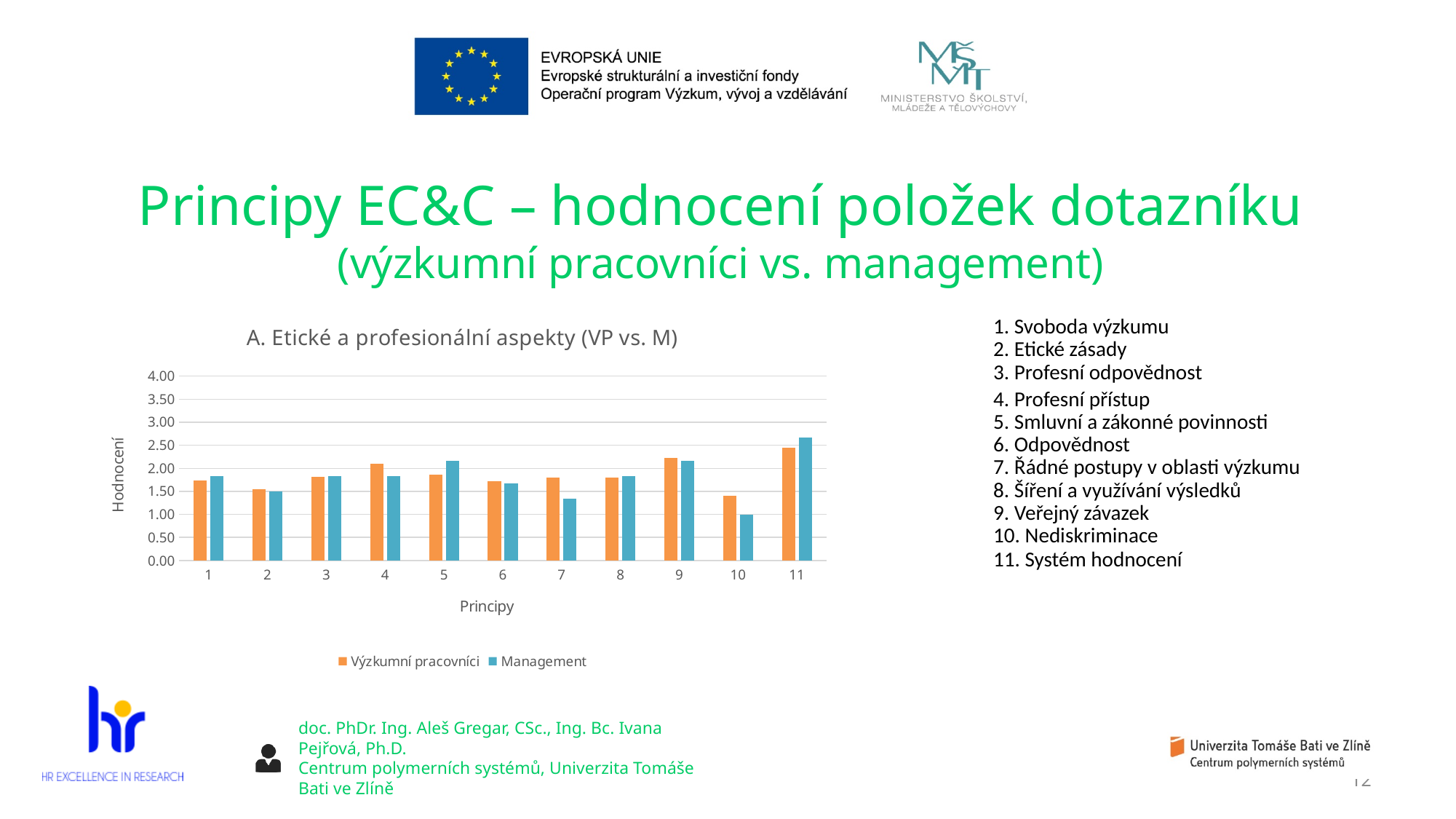
What is the title of the chart? A. Etické a profesionální aspekty (VP vs. M) Is the Management value for principle 11 greater or less than 2.50? greater For principle 5, which series has the larger value, Výzkumní pracovníci or Management? Management For principle 7, which series has the larger value, Výzkumní pracovníci or Management? Výzkumní pracovníci What label is shown on the vertical axis of the chart? Hodnocení Is the Management value for principle 7 greater or less than 1.50? less How many principles (categories) are shown on the x axis of the chart? 11 What kind of chart is shown on the slide? bar chart For which principle is the Výzkumní pracovníci value highest? 11 How many series does the chart's legend list? 2 For which principle is the Management value lowest? 10 For which principle is the Management value highest? 11